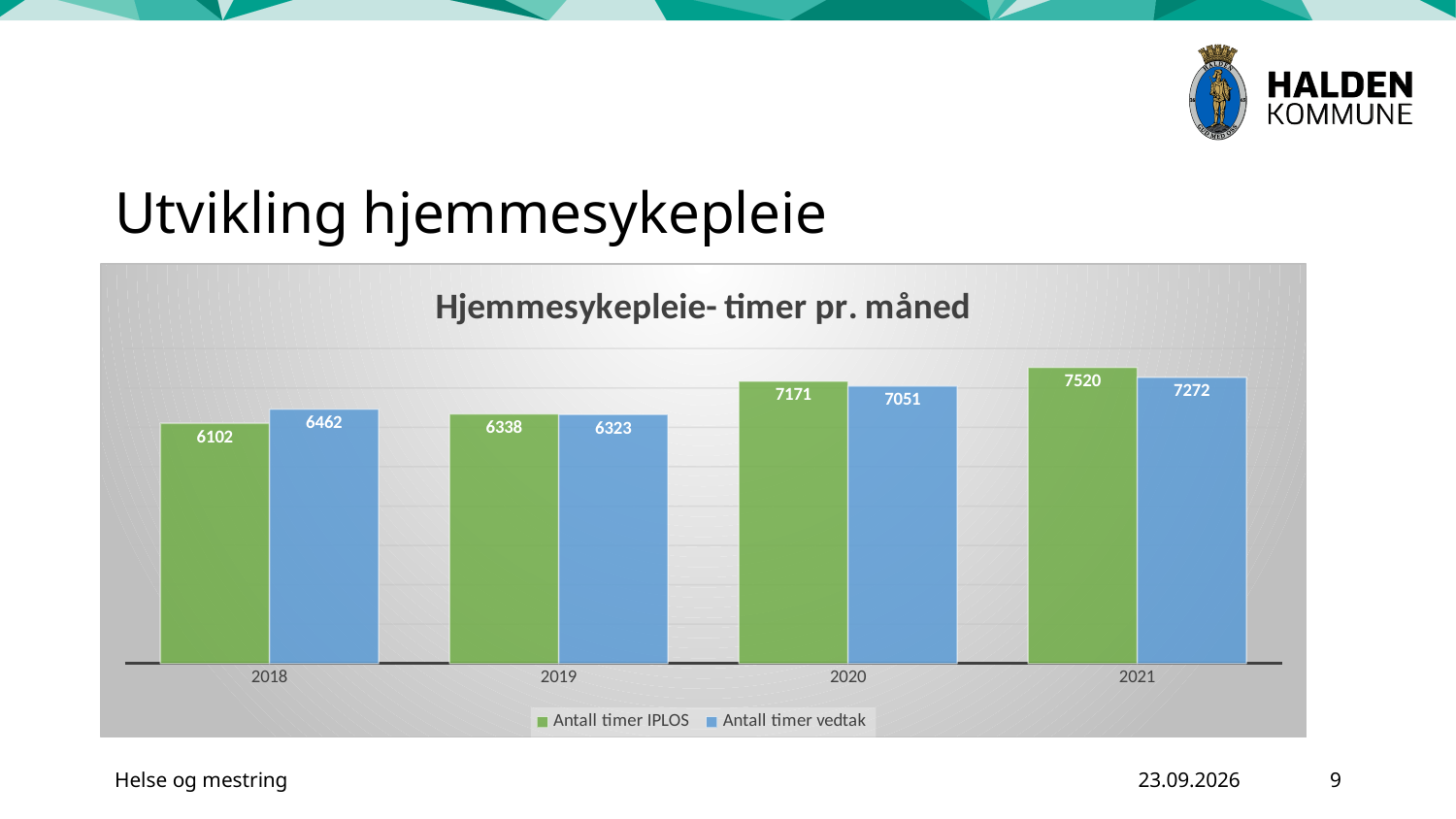
How many years are shown on the x axis? 4 Do the Antall timer IPLOS values rise or fall from 2018 to 2021? Rise In 2020, which is larger: Antall timer IPLOS or Antall timer vedtak? Antall timer IPLOS What is the difference between Antall timer IPLOS in 2021 and in 2020? 349 What is the value of Antall timer vedtak for 2021? 7272 What is the value of Antall timer IPLOS for 2018? 6102 Which year has the lowest value for Antall timer vedtak? 2019 What kind of chart is shown? Bar chart Which year has the highest value for Antall timer IPLOS? 2021 How many series does the legend list? 2 What is the difference between Antall timer IPLOS and Antall timer vedtak in 2018? 360 What is the value of Antall timer vedtak for 2019? 6323